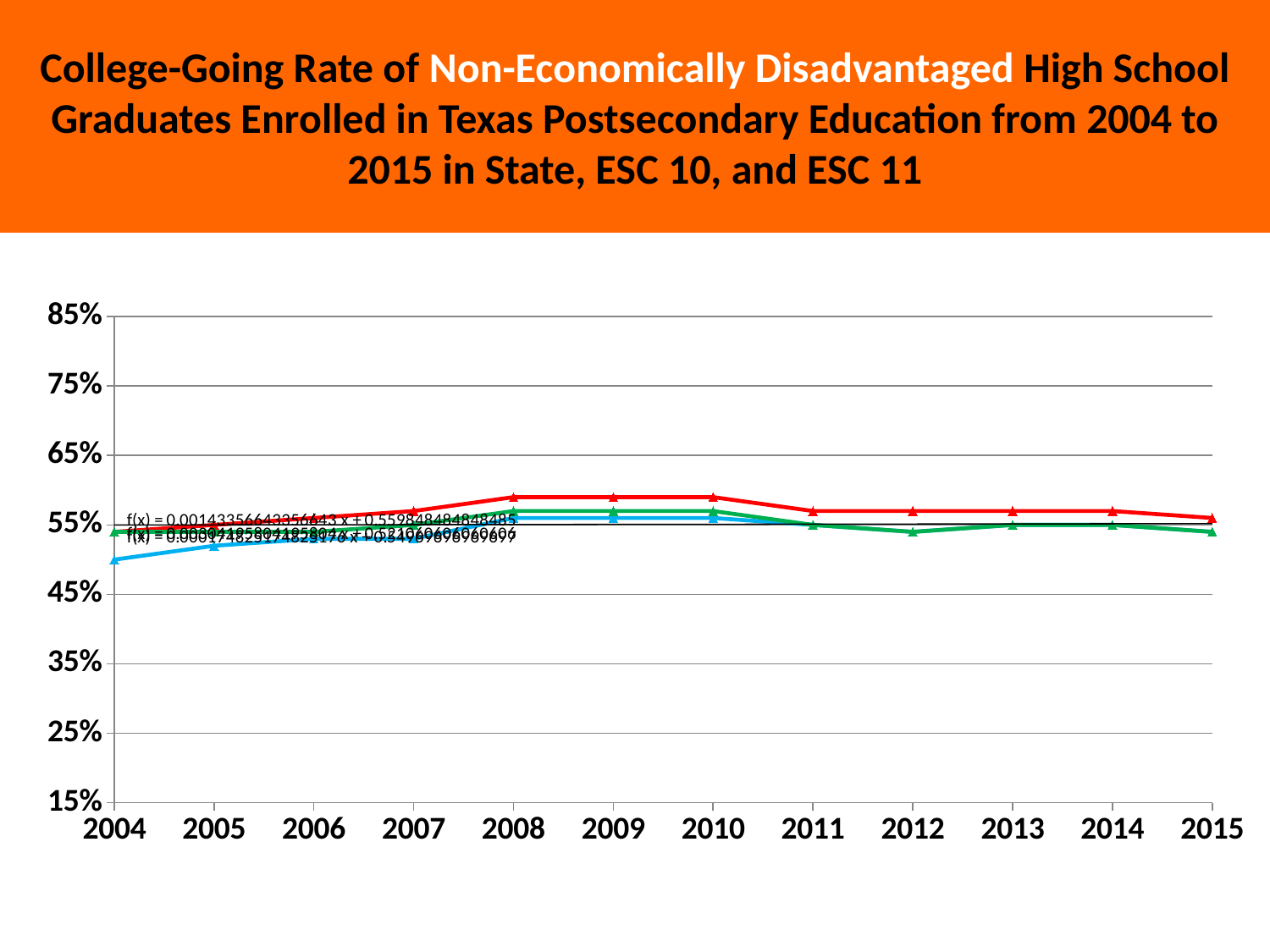
Does the blue line rise or fall from 2004 to 2008? rise Is the value of the red line in 2010 greater or less than 65%? less In 2008, which line has the higher value, the red line or the blue line? red line What is the first year shown on the x axis? 2004 What is the highest value shown on the y axis? 85% How many lines are plotted on the chart? 3 Is the value of the blue line in 2004 greater or less than 55%? less In 2004, which line has the lower value, the red line or the blue line? blue line How many years are shown along the x axis of the chart? 12 Is the value of the red line in 2008 greater or less than 55%? greater What kind of chart is shown on the slide? line chart